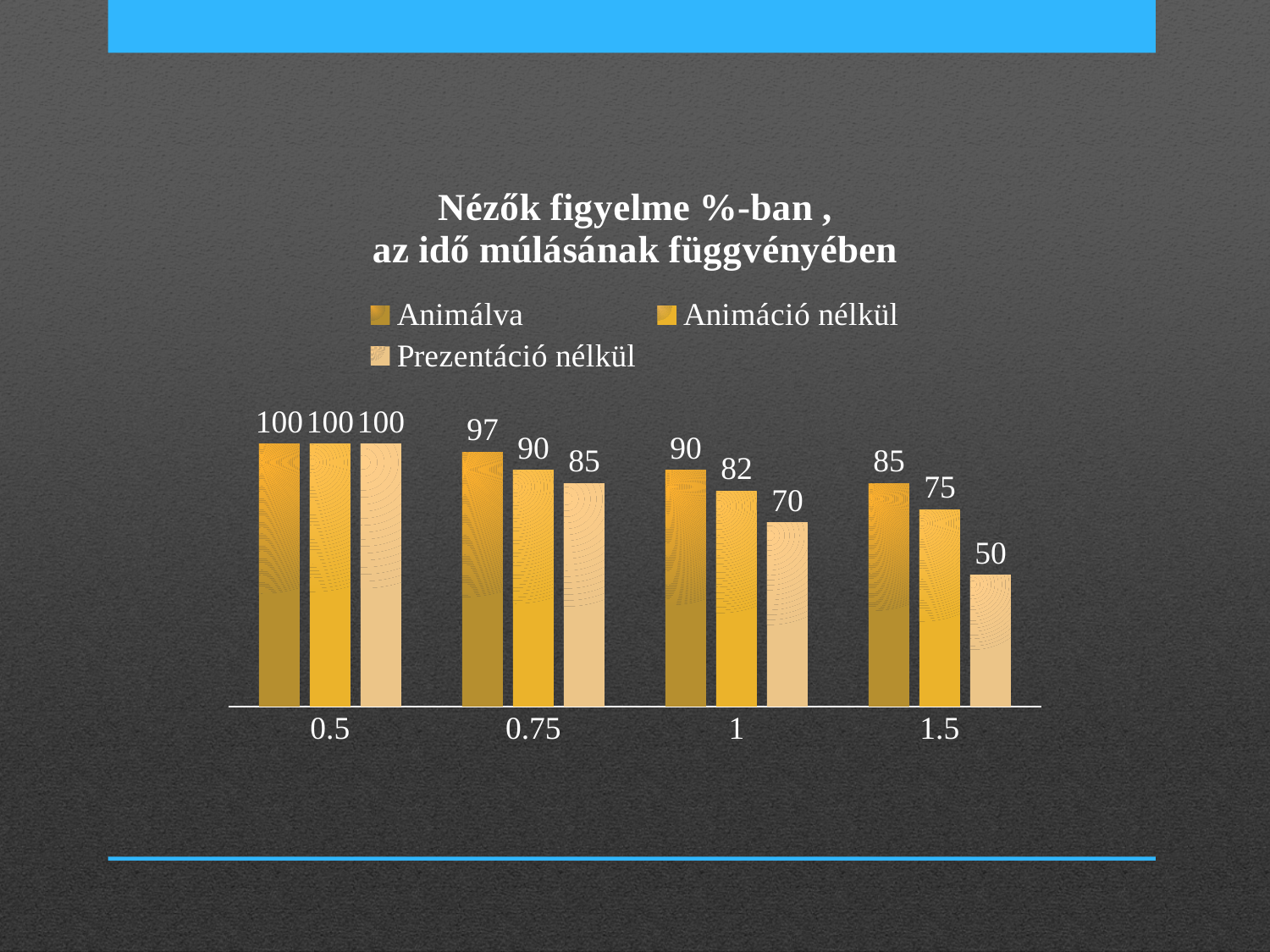
What is the difference between Animálva and Prezentáció nélkül at 1.5? 35 How many categories are shown on the x axis? 4 What kind of chart is this? bar chart Do the values for Prezentáció nélkül rise or fall along the x axis? fall What is the title of the chart? Nézők figyelme %-ban , az idő múlásának függvényében What is the difference between Animáció nélkül at 0.75 and at 1? 8 Which category has the lowest value for Prezentáció nélkül? 1.5 Which is larger at 1: Animálva or Prezentáció nélkül? Animálva What is the value for Animáció nélkül at 1? 82 What is the value for Prezentáció nélkül at 1.5? 50 How many series does the legend list? 3 What is the value for Animálva at 0.75? 97